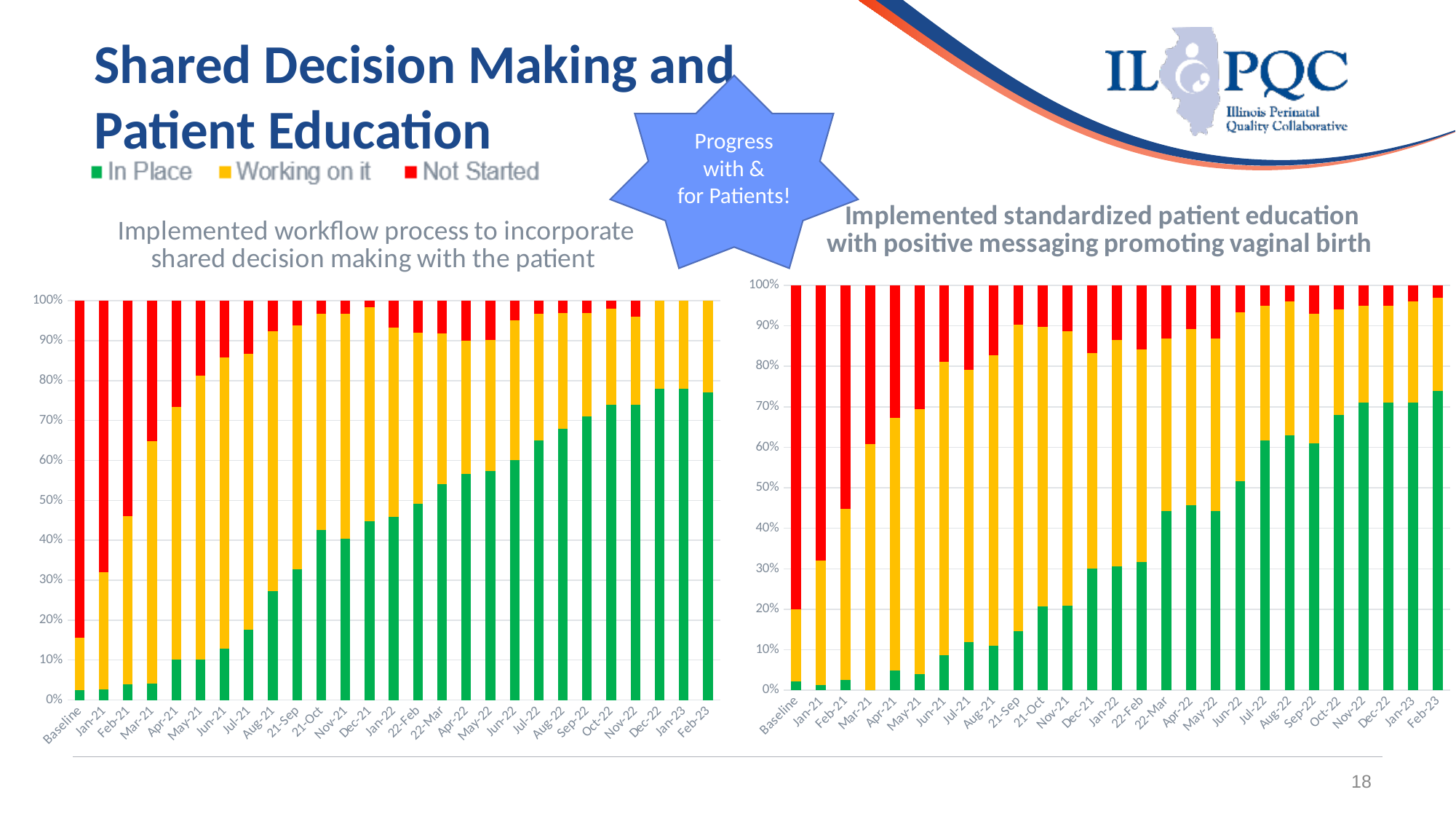
In the left chart, which has the larger 'In Place' value: Baseline or Feb-23? Feb-23 In the right chart, which has the larger 'Not Started' value: Baseline or Feb-23? Baseline In the right chart, is the 'In Place' value for Apr-21 greater or less than 10%? less In the left chart, is the 'In Place' value for Feb-23 greater or less than 70%? greater Which colour represents the 'In Place' series in the legend? Green In the left chart, does the 'In Place' share generally rise or fall from Baseline to Feb-23? Rise How many series does the legend list for the charts on this slide? 3 In the left chart, is the 'In Place' value for Baseline greater or less than 10%? less How many time-period categories are shown along the x axis of the right chart, 'Implemented standardized patient education with positive messaging promoting vaginal birth'? 27 In the right chart, does the 'Not Started' share generally rise or fall from Baseline to Feb-23? Fall What kind of chart is the left chart, 'Implemented workflow process to incorporate shared decision making with the patient'? Stacked bar chart